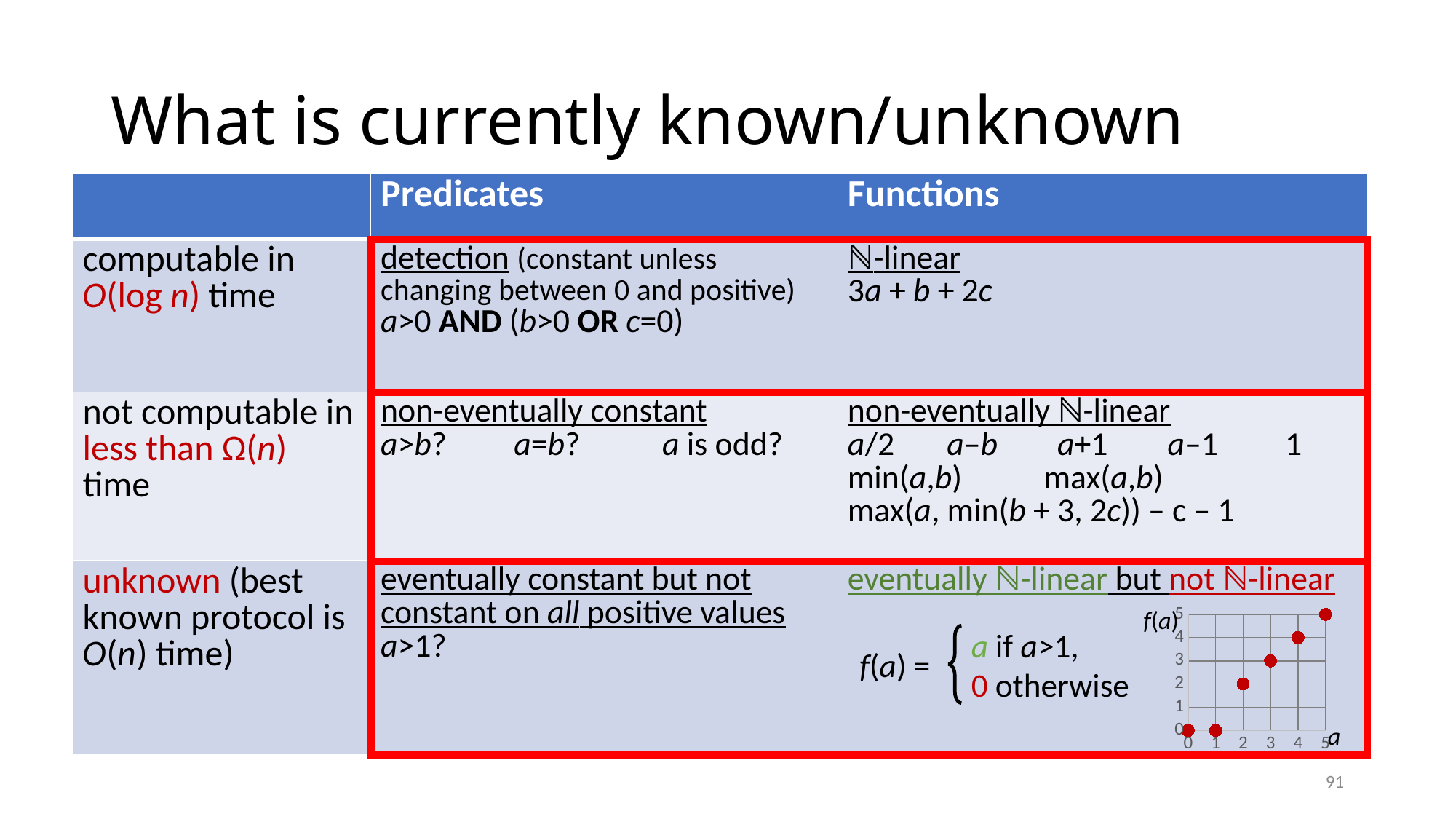
In the scatter plot of f(a), what is the difference between f(a) at a = 4 and f(a) at a = 2? 2 In the scatter plot of f(a), what is the lowest plotted value of f(a)? 0 What kind of chart is shown in the bottom-right cell of the table? scatter plot In the scatter plot of f(a), which is larger: f(a) at a = 2 or f(a) at a = 1? f(a) at a = 2 In the scatter plot of f(a), how many data points are plotted? 6 In the scatter plot of f(a), what is the label on the vertical axis? f(a) In the scatter plot of f(a), what is the value of f(a) at a = 5? 5 In the scatter plot of f(a), at which value of a is f(a) highest? 5 In the scatter plot of f(a), what is the value of f(a) at a = 1? 0 In the scatter plot of f(a), what is the value of f(a) at a = 3? 3 In the scatter plot of f(a), do the values of f(a) generally rise or fall as a increases from 1 to 5? rise In the scatter plot of f(a), what colour are the plotted points? red